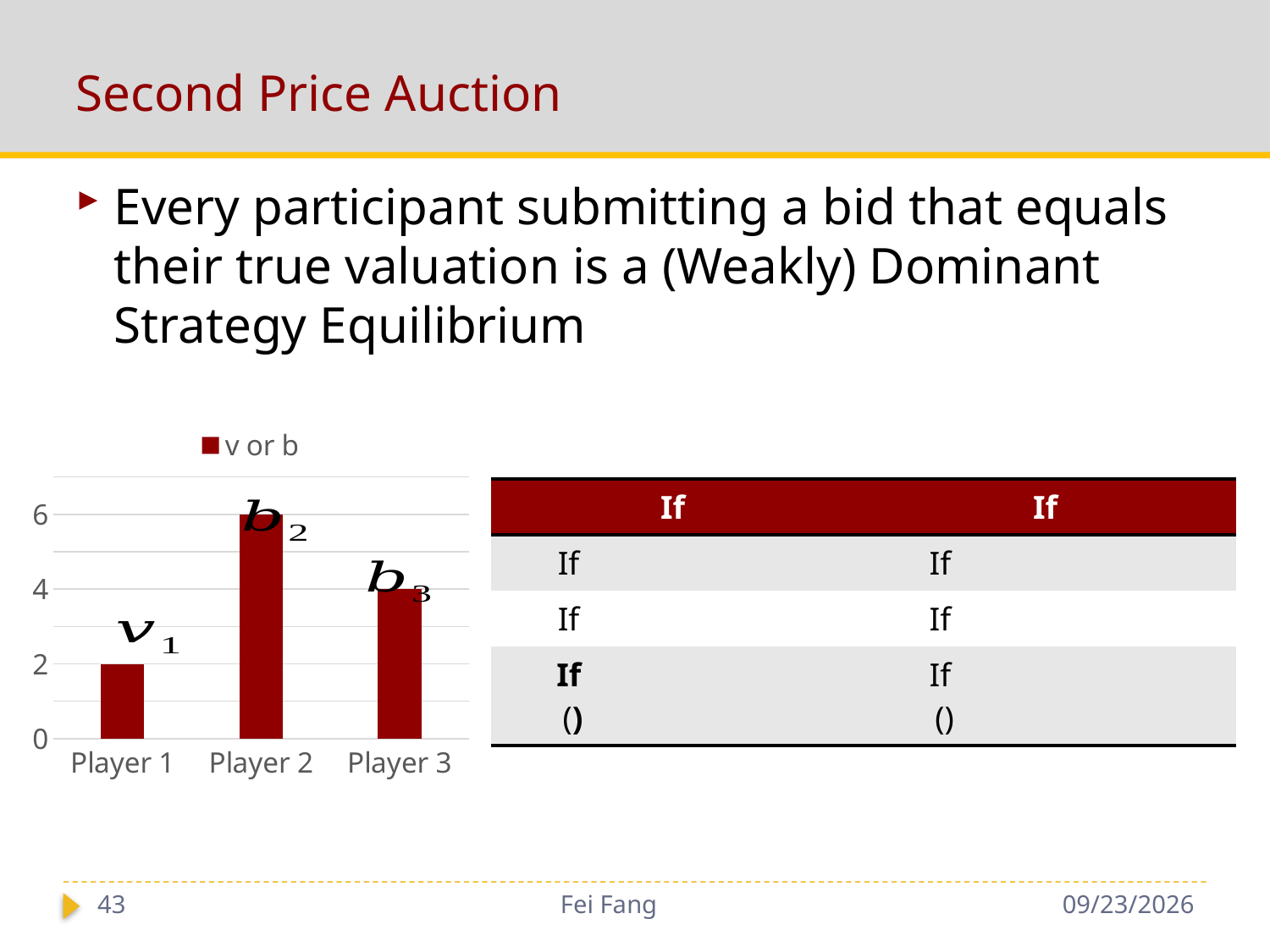
What is the difference between the values for Player 2 and Player 3? 2 What is the value for Player 2 in the chart? 6 How many series does the chart's legend list? 1 Is the value for Player 2 greater or less than 4? greater Which player has the highest bar in the chart? Player 2 What is the value for Player 3 in the chart? 4 What is the legend entry of the chart? v or b Which is larger, the value for Player 1 or the value for Player 3? Player 3 What kind of chart is shown on the slide? bar chart Which player has the lowest bar in the chart? Player 1 How many players (categories) are shown on the x axis of the chart? 3 What is the value for Player 1 in the chart? 2